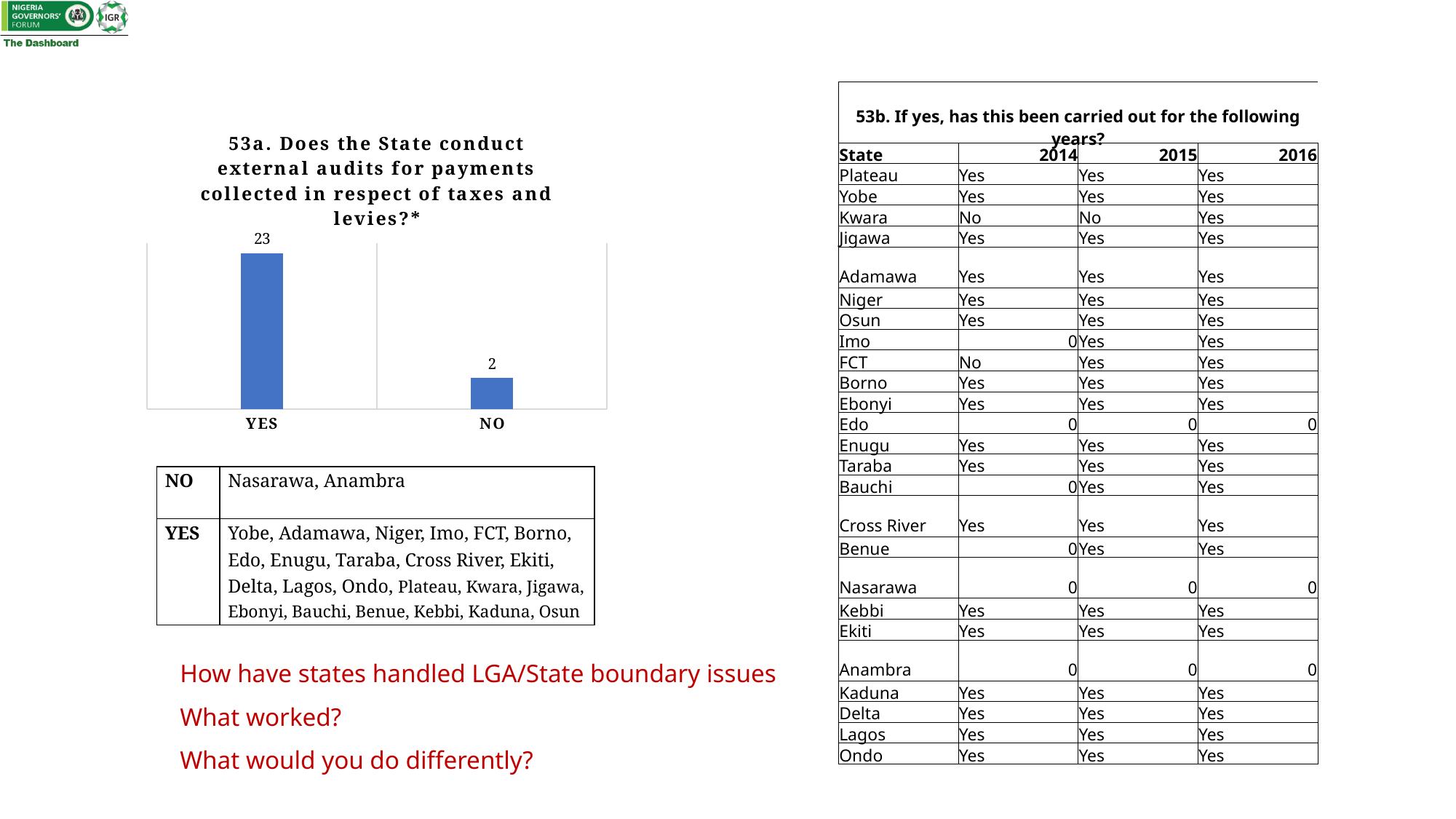
What is the total of the YES and NO values in the chart? 25 Which is larger in the chart, the YES value or the NO value? YES What colour are the bars in the chart? Blue What is the value of the NO bar in the chart? 2 How many categories are shown in the chart? 2 What is the title of the chart? 53a. Does the State conduct external audits for payments collected in respect of taxes and levies?* Which category has the highest value in the chart? YES Which category has the lowest value in the chart? NO What is the value of the YES bar in the chart? 23 What kind of chart is shown on the slide? Bar chart What is the difference between the YES and NO values in the chart? 21